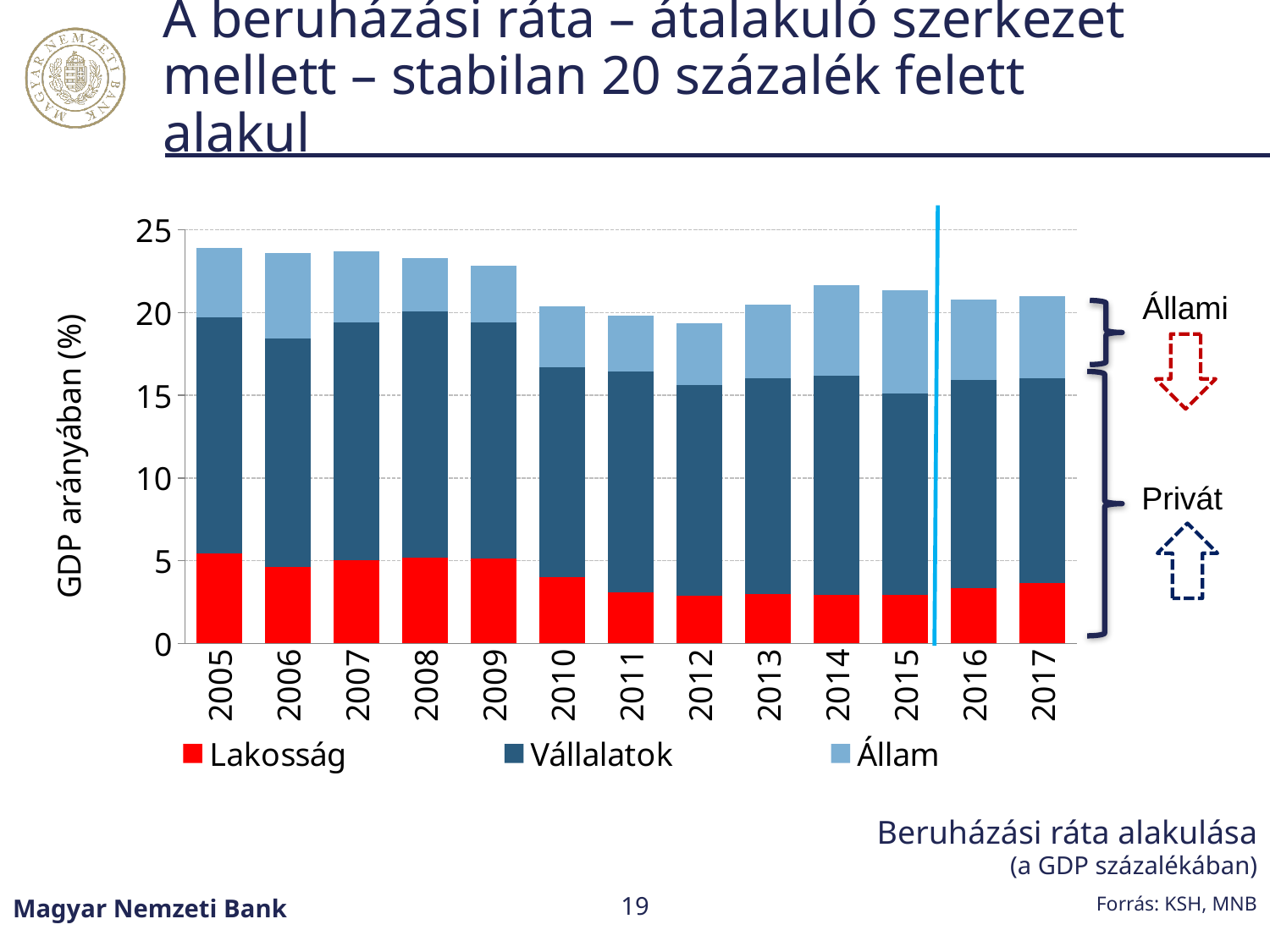
Which year has the larger total bar, 2005 or 2012? 2005 Is the Lakosság value for 2012 greater or less than 5? less Which series are listed in the chart legend? Lakosság, Vállalatok, Állam What is the label of the vertical axis? GDP arányában (%) Is the total investment rate for 2009 greater or less than 20? greater Is the Lakosság value for 2005 greater or less than 5? greater How many series does the chart legend list? 3 What kind of chart is shown on the slide? stacked bar chart How many years are shown on the x axis of the chart? 13 Which year has the larger Lakosság value, 2005 or 2011? 2005